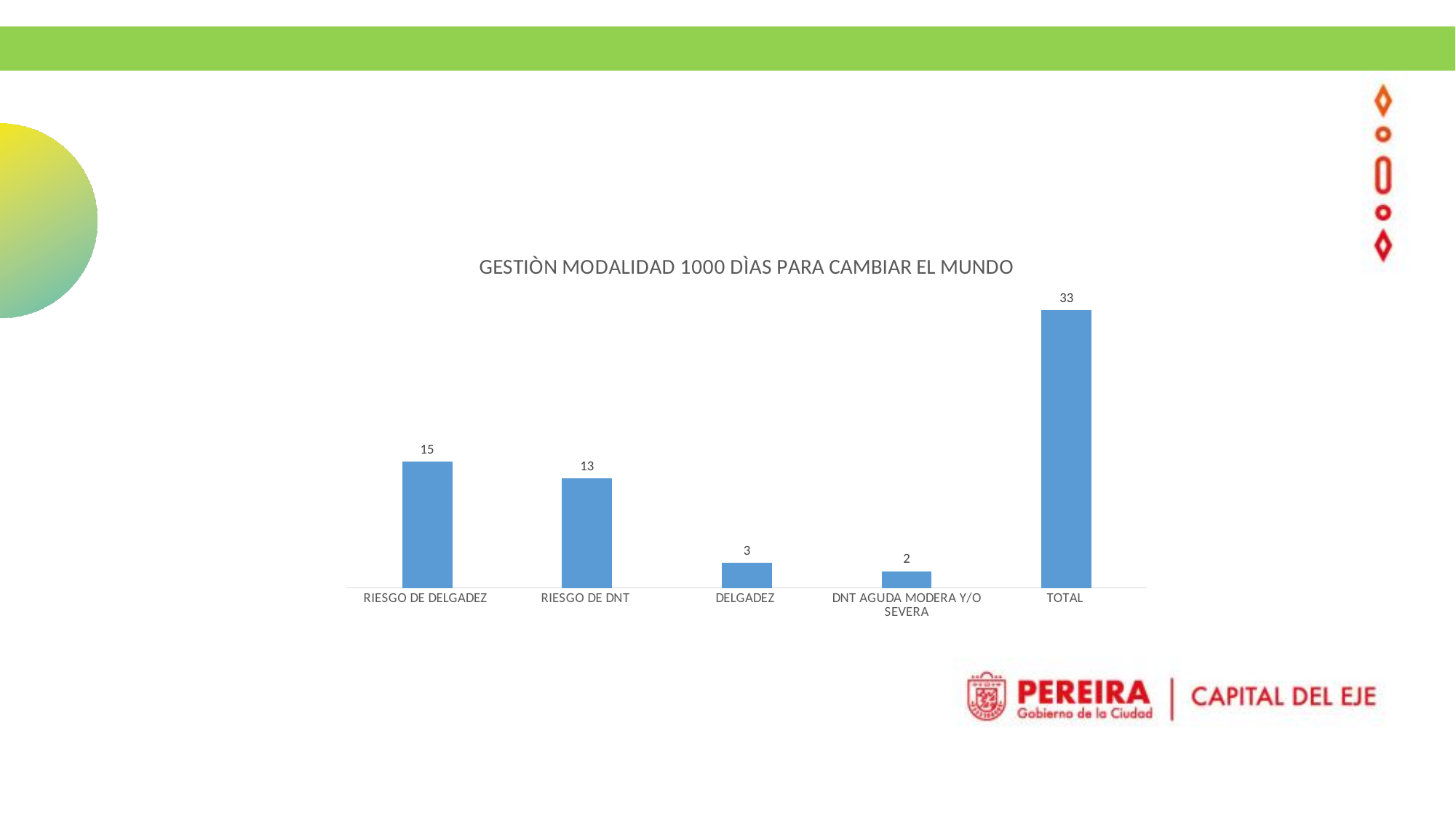
What kind of chart is shown on the slide? Bar chart Which category has the lowest value? DNT AGUDA MODERA Y/O SEVERA What is the title of the chart? GESTIÒN MODALIDAD 1000 DÌAS PARA CAMBIAR EL MUNDO What is the difference between the values for RIESGO DE DELGADEZ and RIESGO DE DNT? 2 Which is larger, the value for DELGADEZ or the value for DNT AGUDA MODERA Y/O SEVERA? DELGADEZ What is the value for RIESGO DE DNT? 13 What is the value for RIESGO DE DELGADEZ? 15 Which category has the highest value? TOTAL How many categories are shown on the x axis? 5 What is the value for TOTAL? 33 What is the value for DNT AGUDA MODERA Y/O SEVERA? 2 What is the value for DELGADEZ? 3